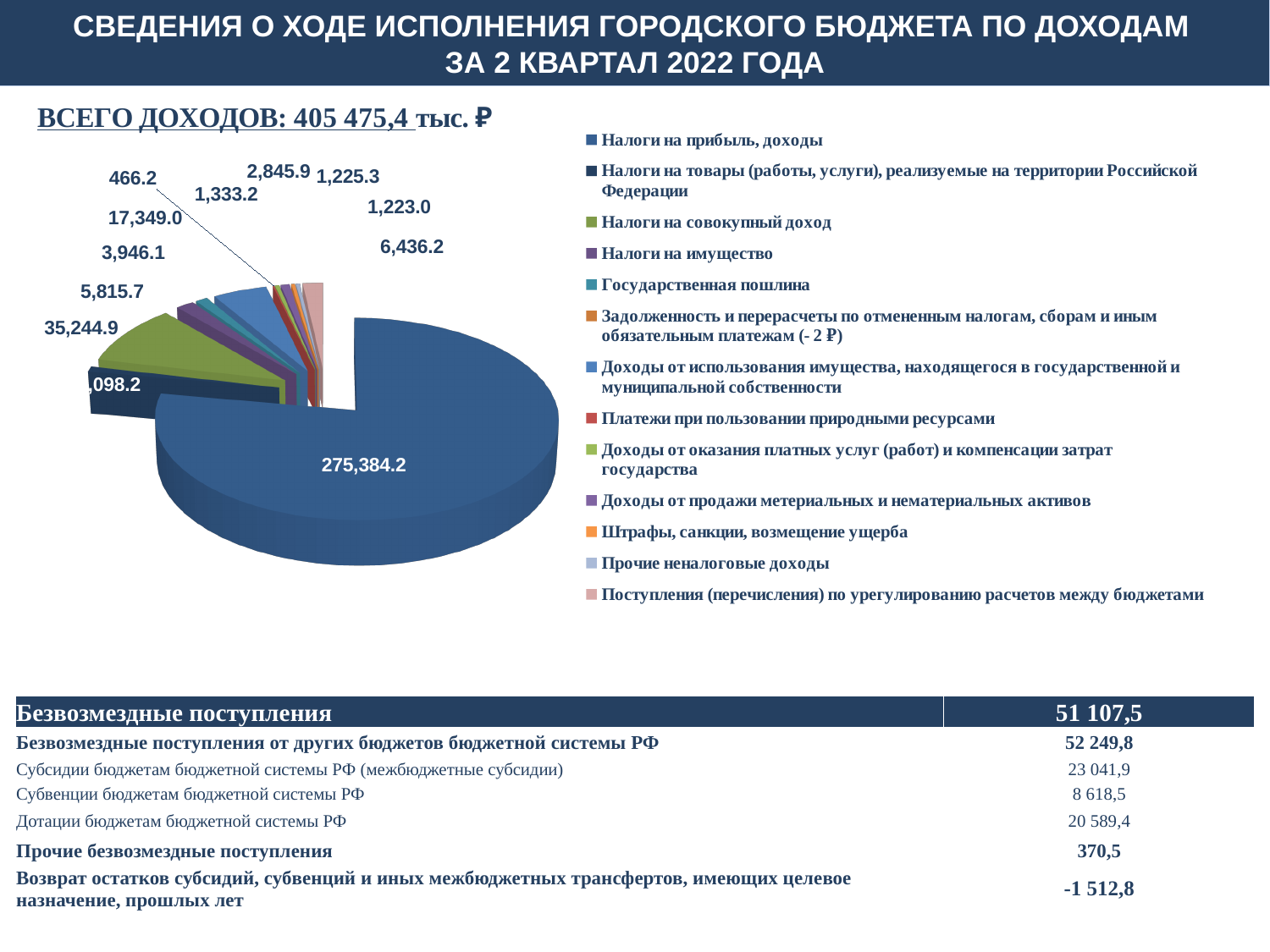
How many entries does the pie chart's legend list? 13 What is the value shown for the largest slice of the pie chart? 275,384.2 Which category has the largest slice in the pie chart? Налоги на прибыль, доходы What is the title shown above the pie chart? ВСЕГО ДОХОДОВ: 405 475,4 тыс. ₽ What is the value shown for Налоги на совокупный доход in the pie chart? 35,244.9 What is the difference between the values for Налоги на прибыль, доходы and Налоги на совокупный доход in the pie chart? 240,139.3 What is the smallest data label shown on the pie chart? 466.2 Which is larger in the pie chart: Налоги на прибыль, доходы or Налоги на совокупный доход? Налоги на прибыль, доходы What kind of chart is shown on the slide? pie chart